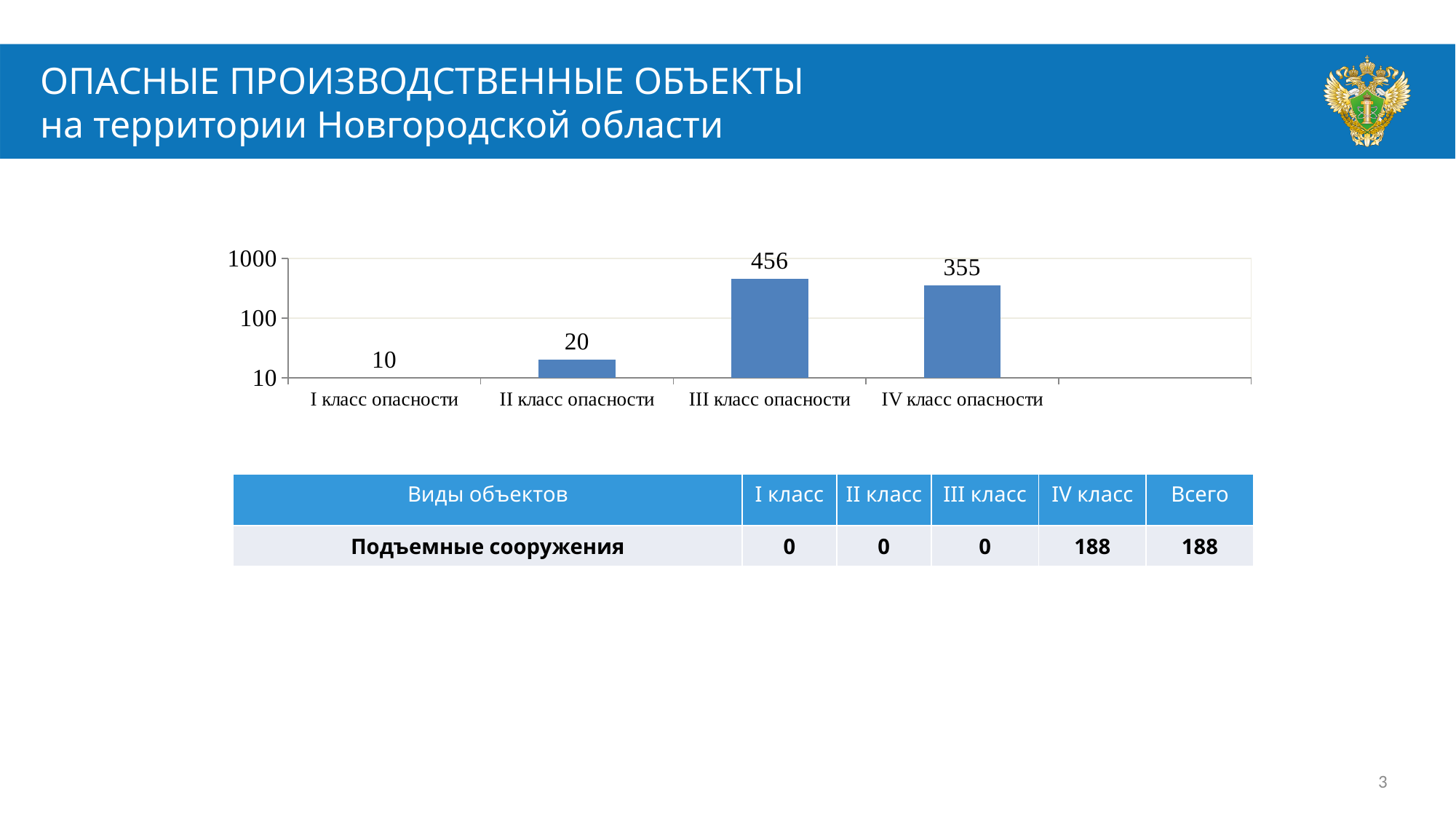
Which category has the highest value? III класс опасности What kind of chart is shown on the slide? bar chart What is the value for IV класс опасности? 355 Is the value for III класс опасности greater or less than 100? greater How many categories are shown on the x axis of the chart? 4 Which is larger, the value for IV класс опасности or the value for II класс опасности? IV класс опасности What is the value for III класс опасности? 456 What is the difference between the values for III класс опасности and IV класс опасности? 101 What is the value for I класс опасности? 10 Which category has the lowest value? I класс опасности What is the difference between the values for II класс опасности and I класс опасности? 10 What is the value for II класс опасности? 20